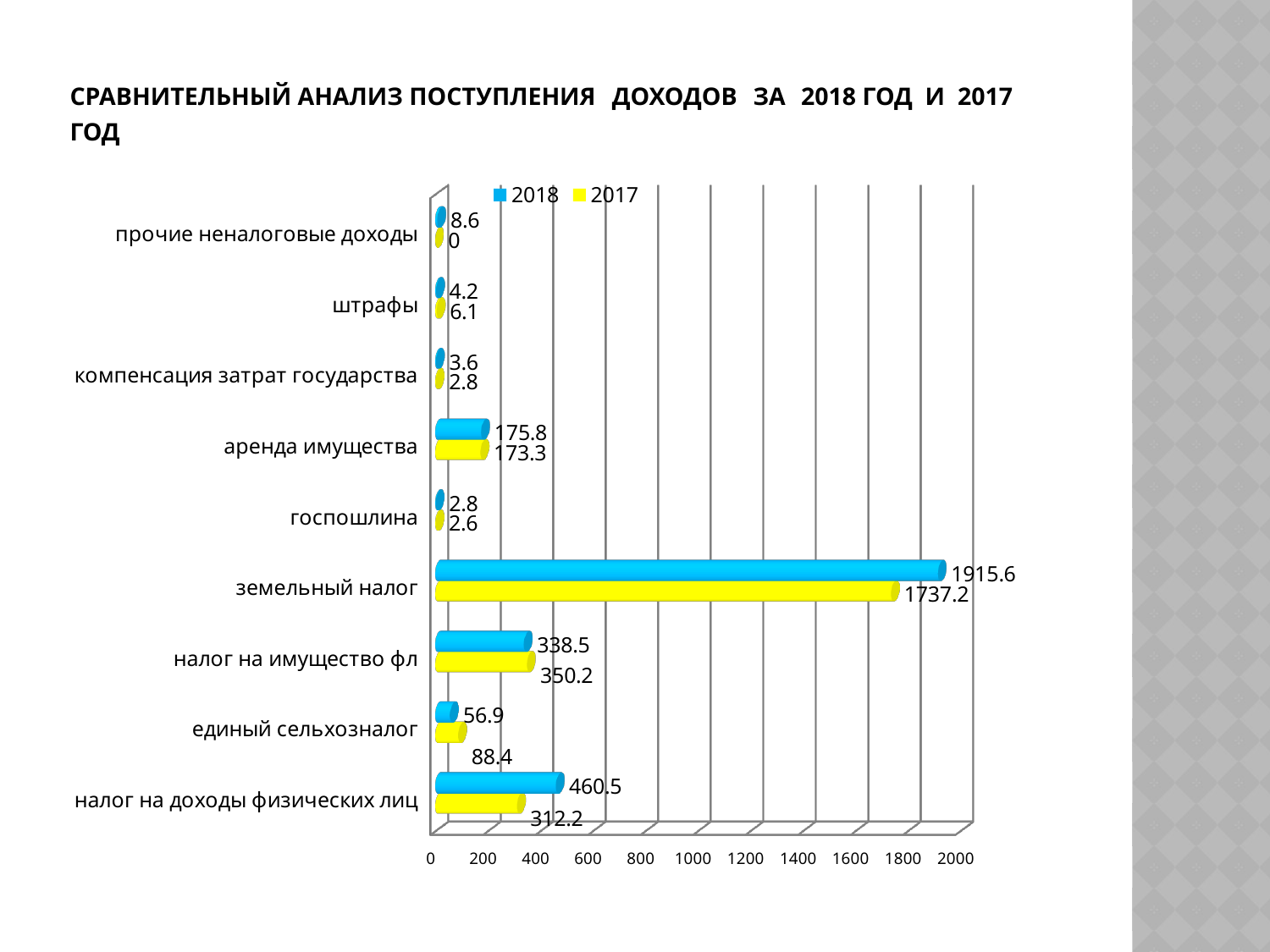
For налог на имущество фл, which year has the larger value, 2018 or 2017? 2017 Which category has the lowest 2017 value? прочие неналоговые доходы How many categories are shown on the chart? 9 What is the 2017 value for налог на доходы физических лиц? 312.2 What is the difference between the 2018 and 2017 values for налог на доходы физических лиц? 148.3 How many series does the legend list? 2 What is the 2018 value for земельный налог? 1915.6 Which category has the highest 2018 value? земельный налог What kind of chart is shown on the slide? bar chart What is the 2017 value for единый сельхозналог? 88.4 What is the 2018 value for аренда имущества? 175.8 What is the difference between the 2018 and 2017 values for земельный налог? 178.4